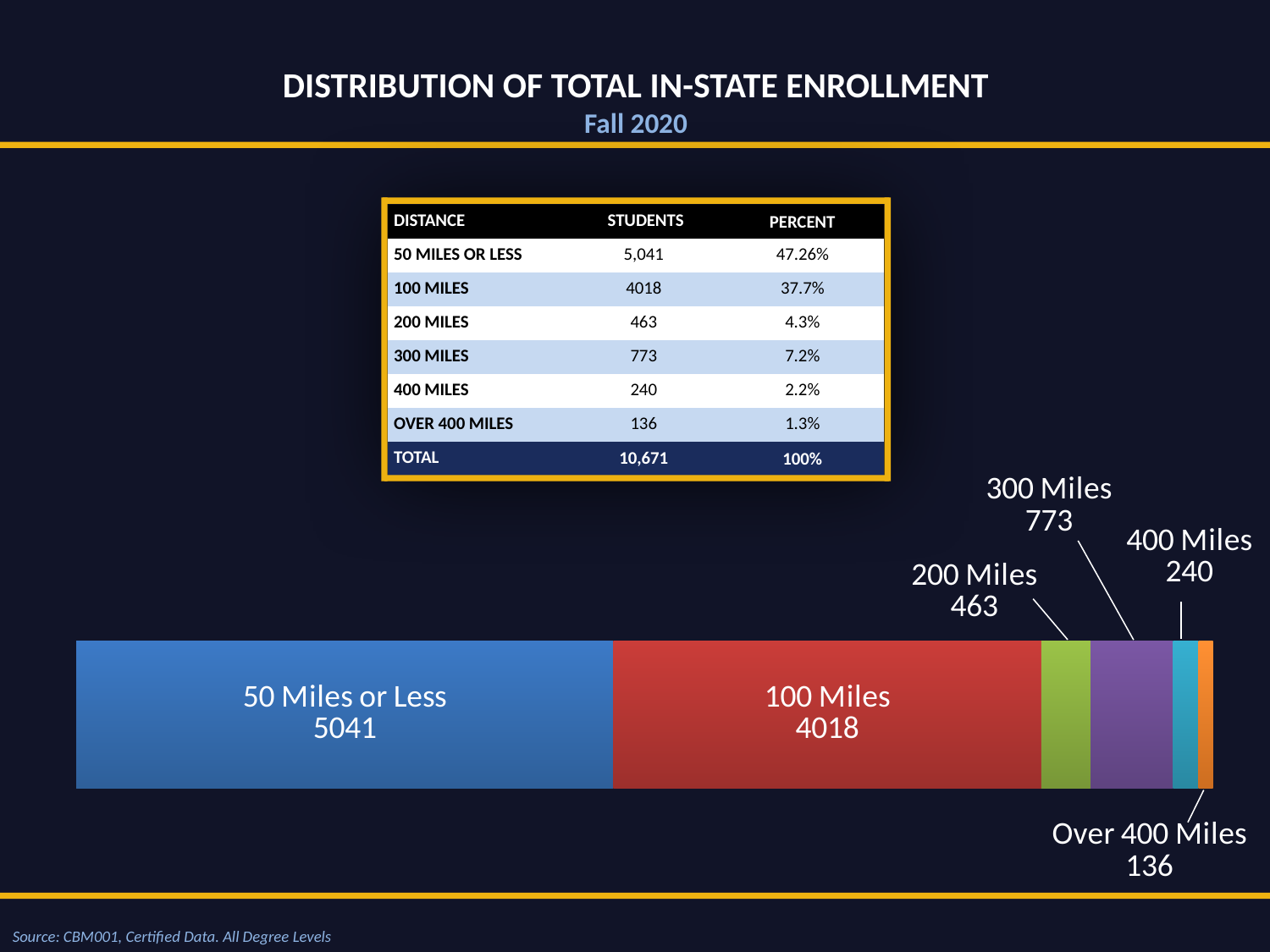
In the bar chart, what is the value for Over 400 Miles? 136 In the bar chart, which is larger: the value for 200 Miles or the value for 300 Miles? 300 Miles In the bar chart, what is the difference between the values for 50 Miles or Less and 100 Miles? 1023 Which segment of the bar chart has the lowest value? Over 400 Miles In the bar chart, what is the value for 100 Miles? 4018 In the bar chart, what is the value for 300 Miles? 773 What colour is the 100 Miles segment in the bar chart? Red How many segments make up the stacked bar in the chart? 6 In the bar chart, what is the value for 50 Miles or Less? 5041 What is the total of all segments in the stacked bar? 10671 What kind of chart is shown on the slide? Stacked bar chart Which segment of the bar chart has the highest value? 50 Miles or Less